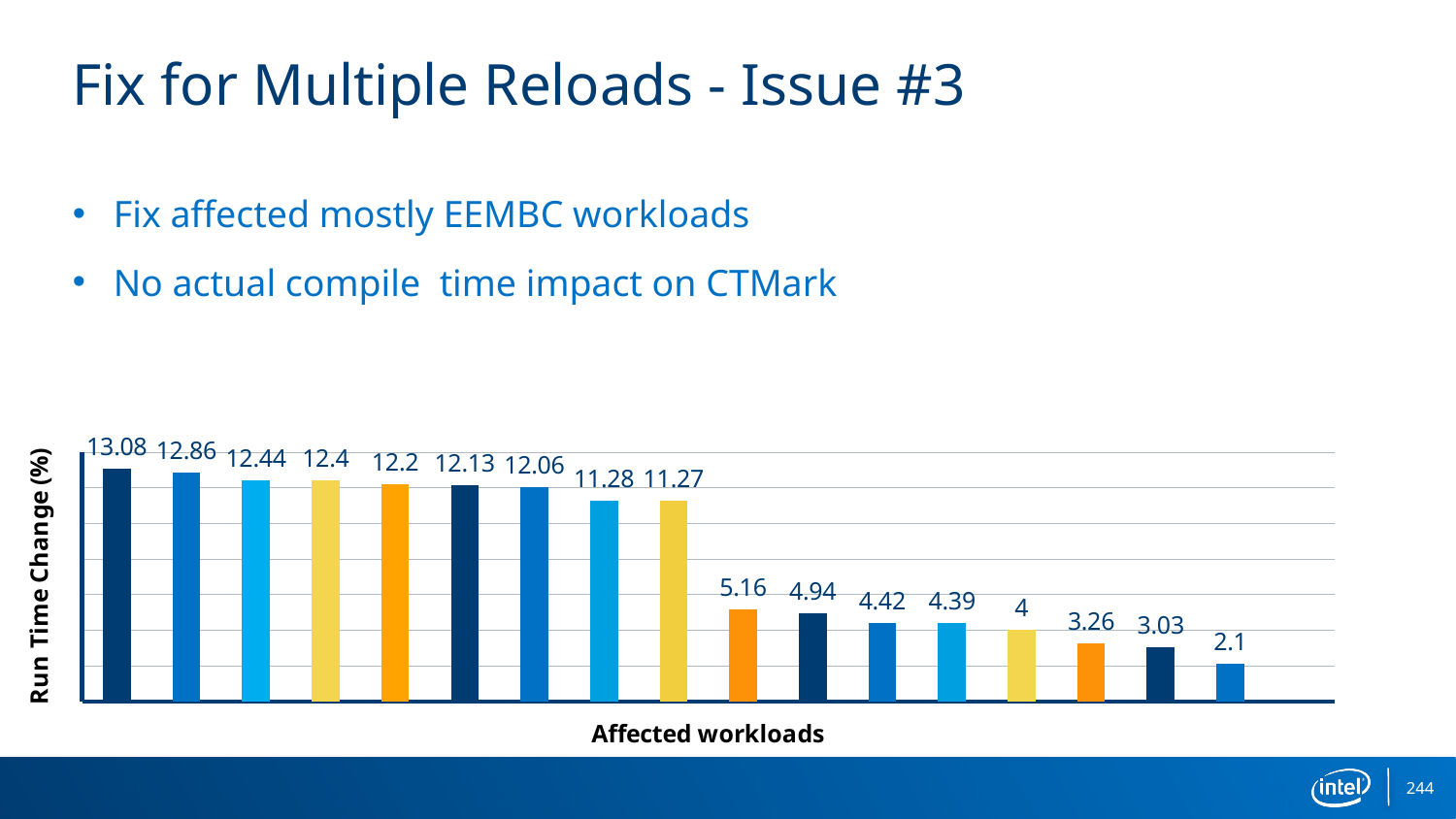
What is the title of the vertical axis? Run Time Change (%) What is the value of the tenth bar from the left in the chart? 5.16 What is the highest value shown in the chart? 13.08 What is the value of the leftmost bar in the chart? 13.08 What is the value of the rightmost bar in the chart? 2.1 What kind of chart is shown on the slide? bar chart Which is larger, the second bar from the left or the second bar from the right? the second bar from the left (12.86) How many bars are plotted in the chart? 17 Do the bar values rise or fall from left to right along the x axis? fall What is the title of the horizontal axis? Affected workloads What is the difference between the leftmost bar (13.08) and the rightmost bar (2.1)? 10.98 What is the lowest value shown in the chart? 2.1